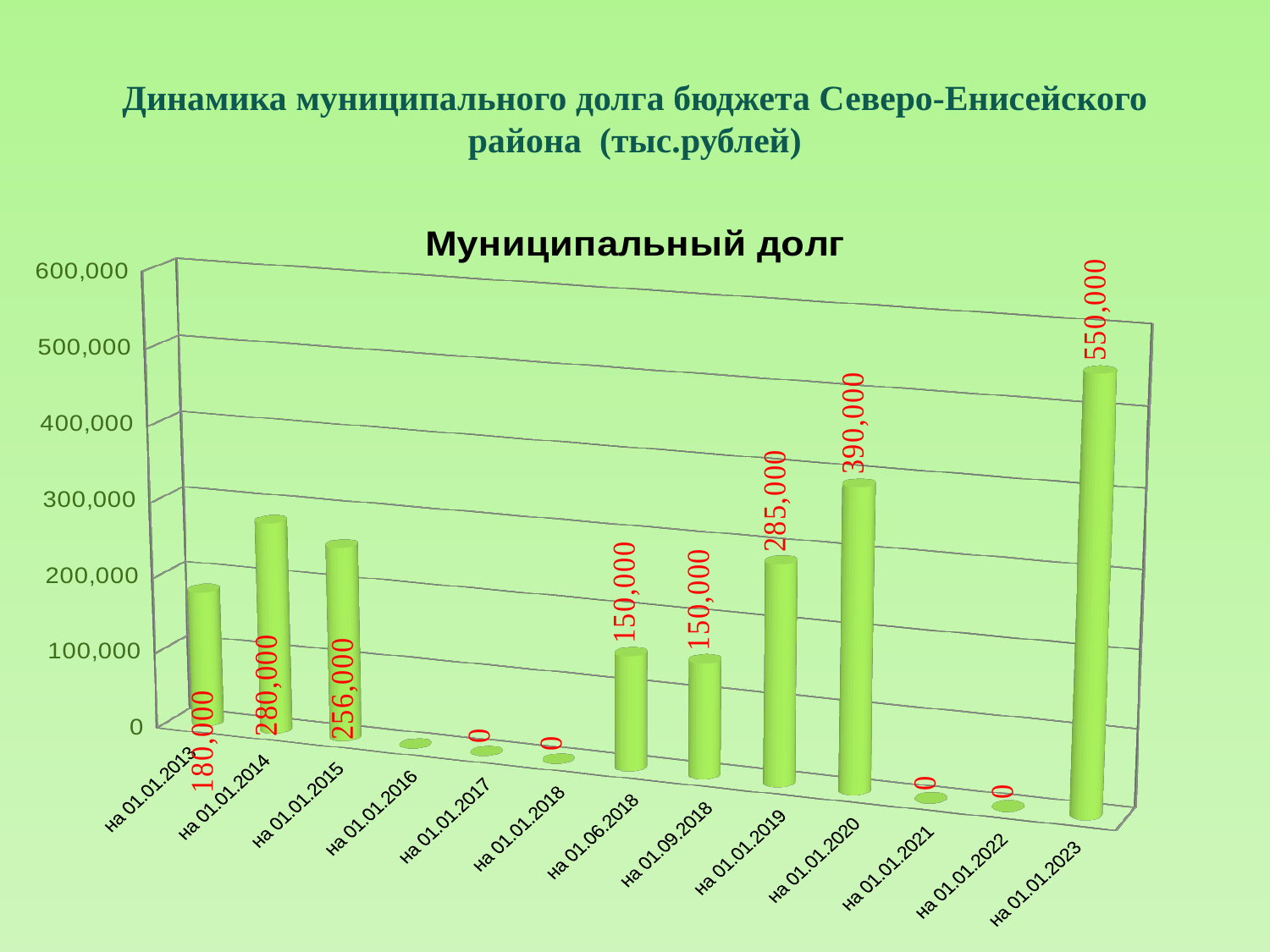
How many categories are shown on the x axis? 13 What kind of chart is this? bar chart What is the title of the chart? Муниципальный долг Which is larger, the value for на 01.01.2019 or the value for на 01.01.2014? на 01.01.2019 What is the value for на 01.06.2018? 150,000 What is the value for на 01.01.2022? 0 Which category has the highest value? на 01.01.2023 What is the value for на 01.01.2015? 256,000 What is the value for на 01.01.2020? 390,000 What is the difference between the values for на 01.01.2023 and на 01.01.2020? 160,000 Is the value for на 01.01.2020 greater or less than 300,000? greater What is the difference between the values for на 01.01.2014 and на 01.01.2013? 100,000